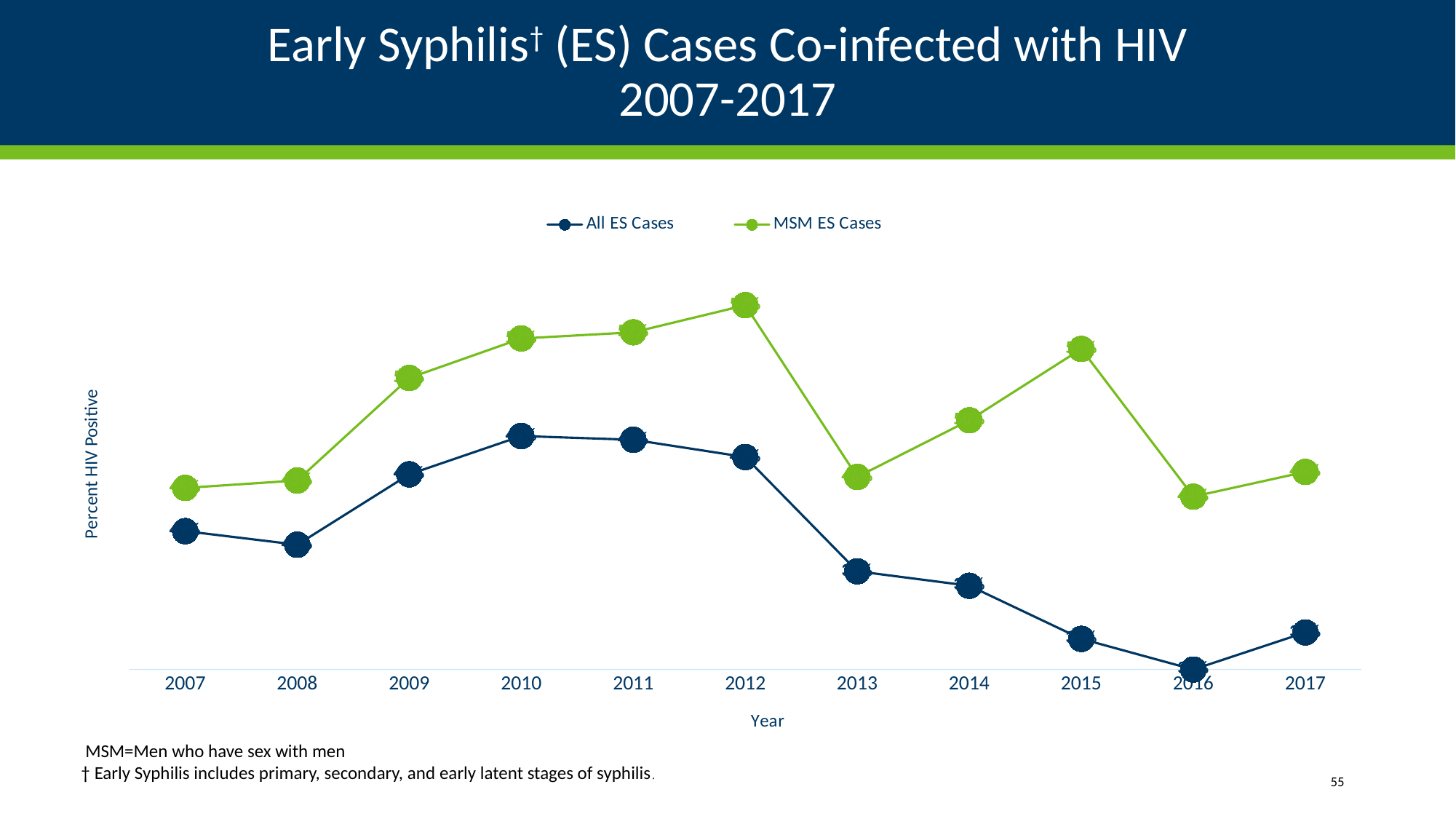
In which year is the MSM ES Cases series at its highest? 2012 How many series does the legend list? 2 In which year is the MSM ES Cases series at its lowest? 2016 Which series is drawn in green? MSM ES Cases In which year is the All ES Cases series at its lowest? 2016 For the All ES Cases series, is the value in 2010 higher or lower than in 2007? higher Do the All ES Cases values rise or fall from 2012 to 2016? fall How many years are plotted along the x axis? 11 Do the MSM ES Cases values rise or fall from 2008 to 2012? rise What kind of chart is shown on the slide? line chart In 2017, which series has the higher percent HIV positive, All ES Cases or MSM ES Cases? MSM ES Cases What is the label of the y axis? Percent HIV Positive